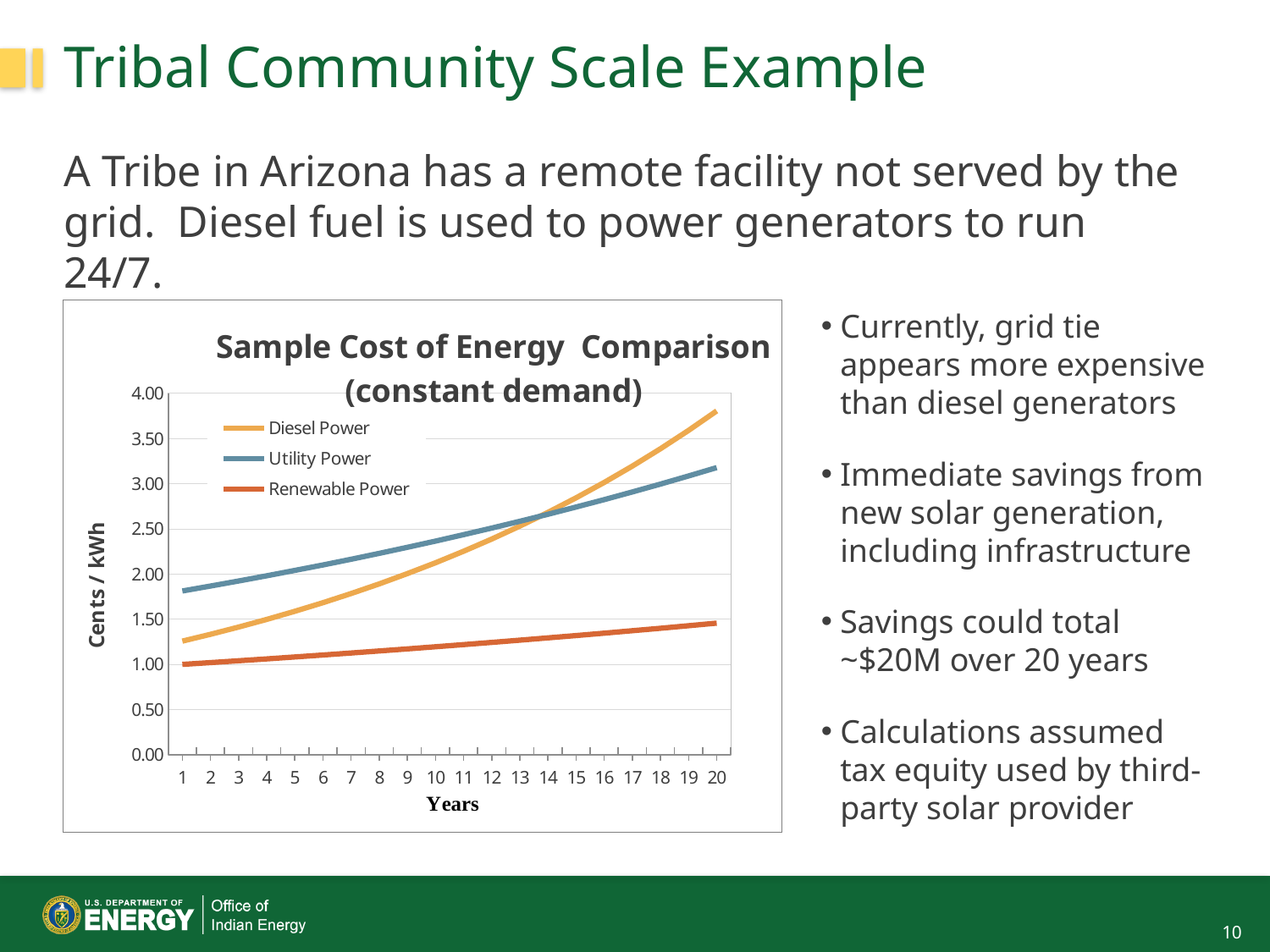
What is the label of the vertical axis of the chart? Cents / kWh Which series has the highest value at year 20? Diesel Power What is the title of the chart? Sample Cost of Energy Comparison (constant demand) Is the value for Diesel Power at year 20 greater or less than 3.50? greater At year 5, which is larger: Diesel Power or Utility Power? Utility Power Is the value for Renewable Power at year 20 greater or less than 1.50? less Which series has the highest value at year 1? Utility Power How many series does the chart legend list? 3 How many years are shown along the x axis of the chart? 20 Which series has the lowest value at year 20? Renewable Power Does the Diesel Power series rise or fall over the years shown? Rise What kind of chart is shown on the slide? Line chart